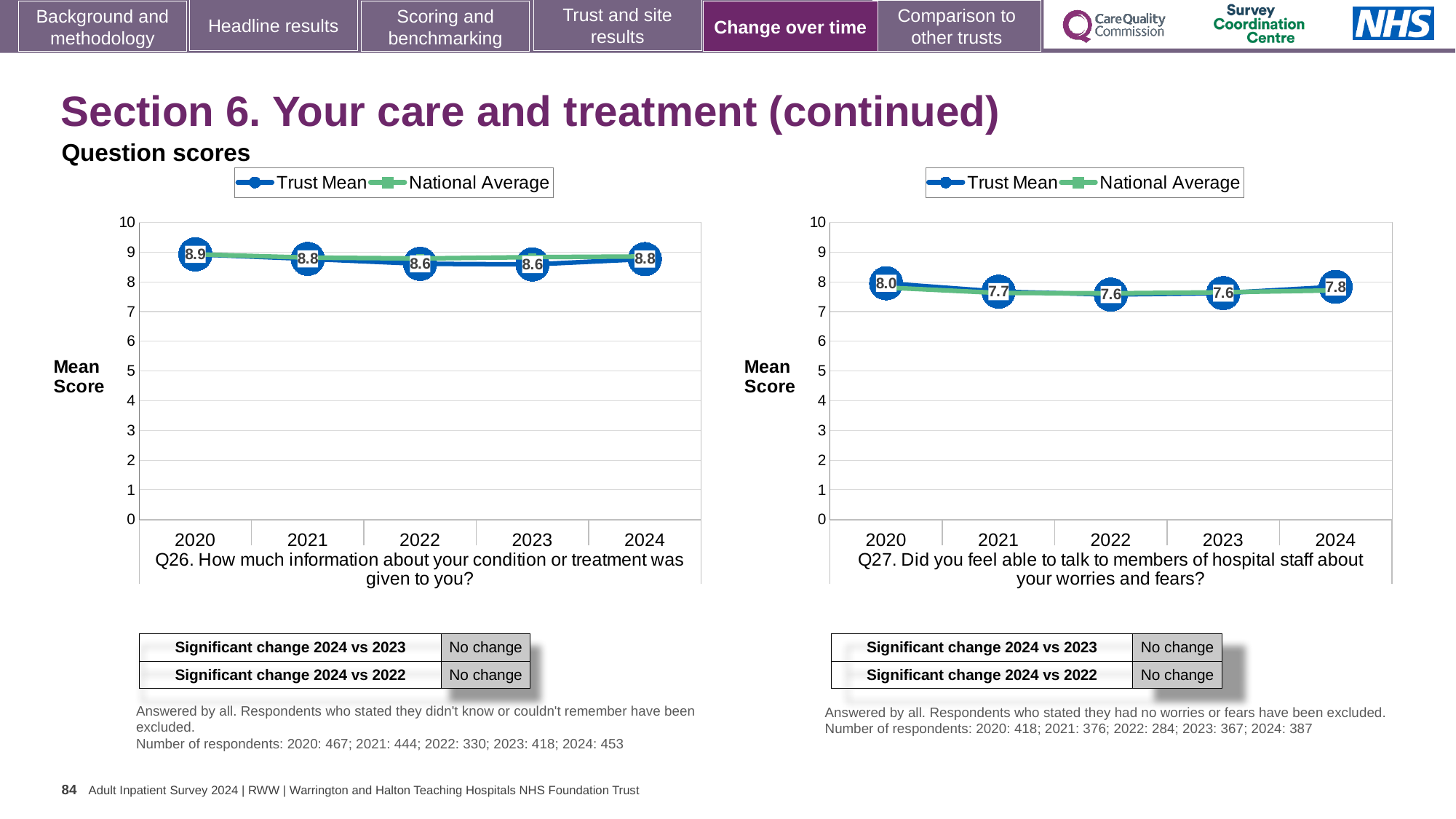
How many years are plotted on the x axis of the Q27 chart (right)? 5 In the Q26 chart (left), is the Trust Mean score for 2022 greater or less than 9? less In the Q26 chart (left), what is the Trust Mean score for 2020? 8.9 In the Q27 chart (right), is the Trust Mean score for 2024 higher or lower than for 2023? higher What type of chart is used for the Q27 chart (right)? Line chart In the Q26 chart (left), what is the difference between the Trust Mean scores for 2020 and 2023? 0.3 How many series does the legend of the Q26 chart (left) list? 2 In the Q27 chart (right), what is the Trust Mean score for 2021? 7.7 In the Q27 chart (right), which year has the highest Trust Mean score? 2020 In the Q26 chart (left), which year has the highest Trust Mean score? 2020 In the Q26 chart (left), what is the Trust Mean score for 2024? 8.8 In the Q27 chart (right), what is the difference between the Trust Mean scores for 2020 and 2022? 0.4